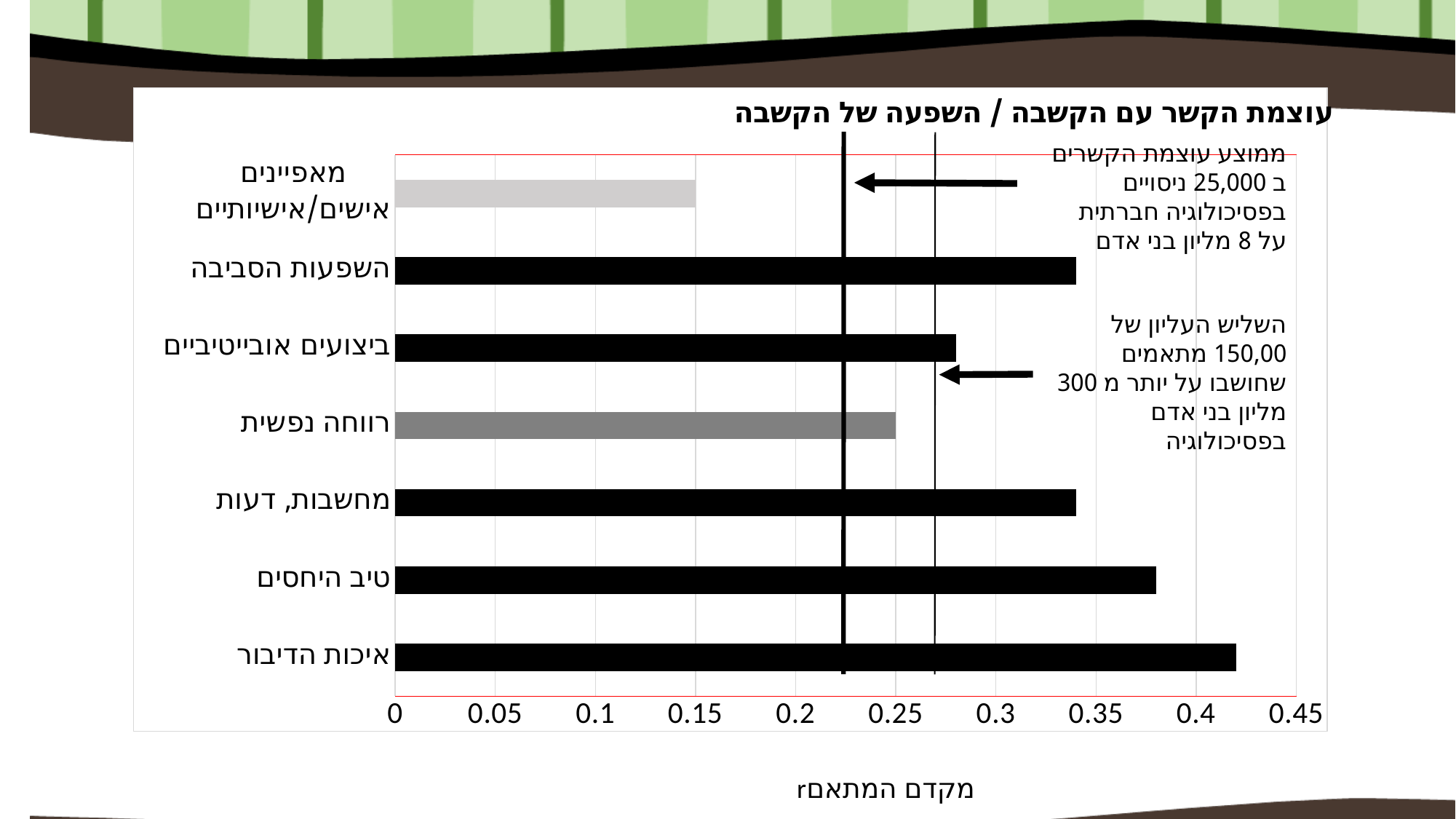
What is the value for רווחה נפשית? 0.25 Which category has the highest value in the chart? איכות הדיבור Which category has the lowest value in the chart? מאפיינים אישים/אישיותיים Is the value for ביצועים אובייטיביים greater or less than 0.25? greater What is the label of the horizontal axis? מקדם המתאם r Is the value for איכות הדיבור greater or less than 0.4? greater Which is larger, the value for טיב היחסים or the value for רווחה נפשית? טיב היחסים How many categories are plotted in the chart? 7 Is the value for השפעות הסביבה greater or less than 0.3? greater What is the value for מאפיינים אישים/אישיותיים? 0.15 What kind of chart is shown on the slide? bar chart What is the title of the chart? עוצמת הקשר עם הקשבה / השפעה של הקשבה